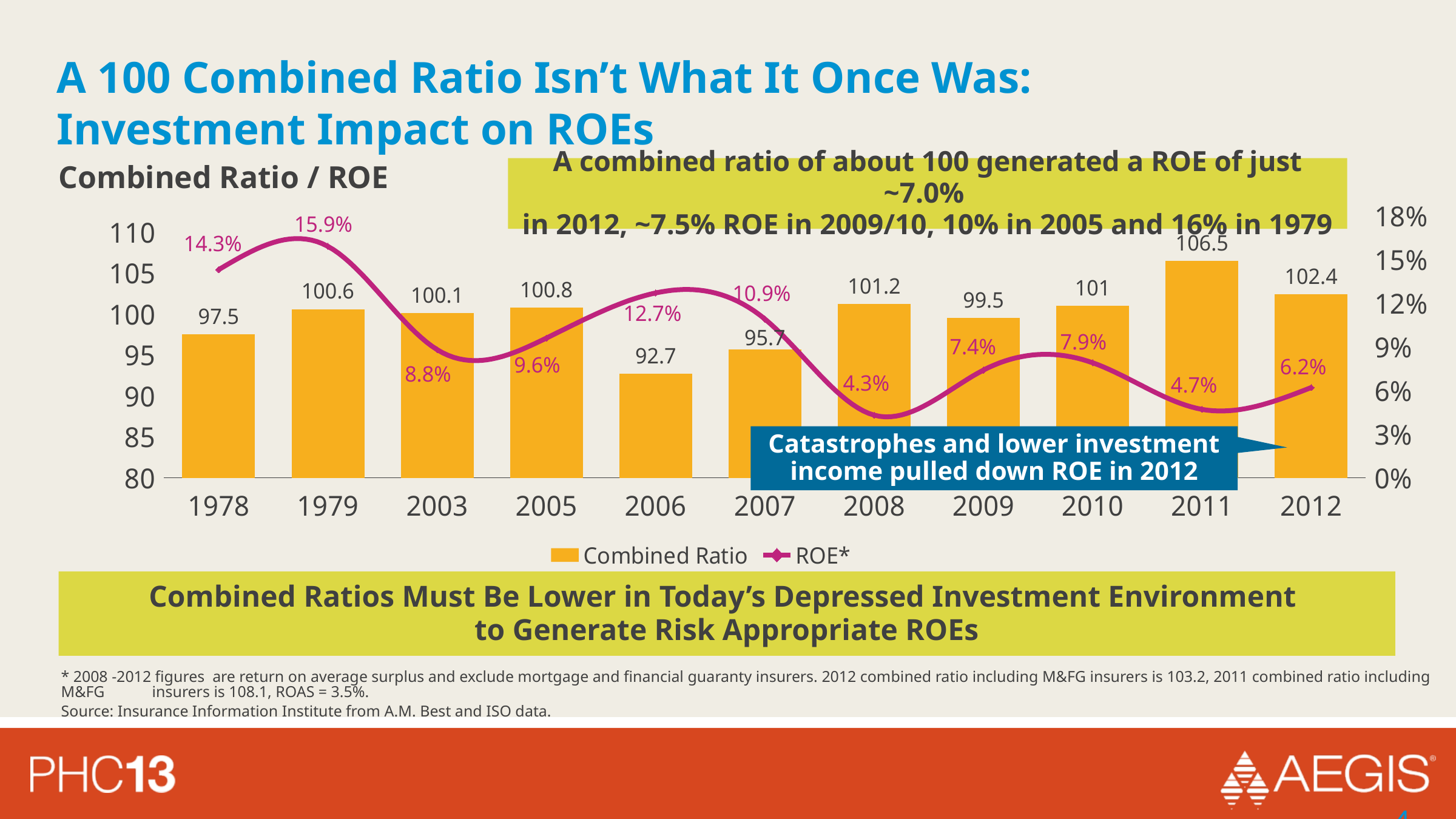
Which year has the highest Combined Ratio? 2011 How many series does the legend list? 2 What kind of chart is this? A bar chart combined with a line chart Which year has the lowest ROE*? 2008 What is the ROE* value for 1979? 15.9% What is the ROE* value for 2012? 6.2% Which year has the highest ROE*? 1979 What is the Combined Ratio for 2011? 106.5 Which year has the lowest Combined Ratio? 2006 What is the difference between the Combined Ratio in 2011 and in 2012? 4.1 How many years are shown on the x axis? 11 Which year has the higher ROE*, 2009 or 2010? 2010